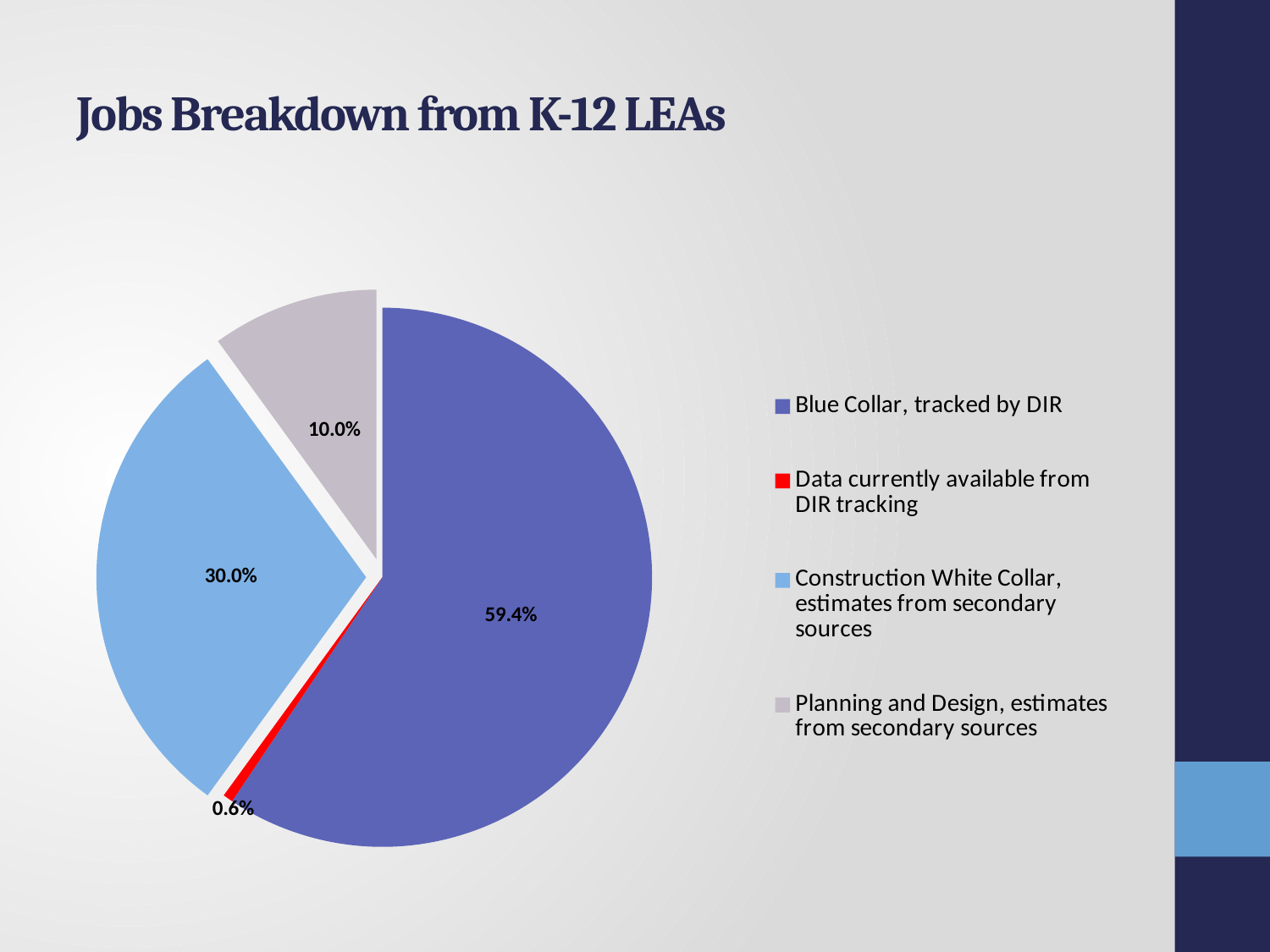
Which is larger: 'Planning and Design, estimates from secondary sources' or 'Construction White Collar, estimates from secondary sources'? Construction White Collar, estimates from secondary sources What is the title of the chart? Jobs Breakdown from K-12 LEAs What share of the pie is 'Blue Collar, tracked by DIR'? 59.4% What is the difference in percentage points between 'Blue Collar, tracked by DIR' and 'Construction White Collar, estimates from secondary sources'? 29.4 Which category has the largest slice of the pie? Blue Collar, tracked by DIR Which category has the smallest slice of the pie? Data currently available from DIR tracking What colour is the slice for 'Data currently available from DIR tracking'? Red What kind of chart is shown on the slide? Pie chart How many categories does the legend list? 4 What share of the pie is 'Construction White Collar, estimates from secondary sources'? 30.0% What share of the pie is 'Data currently available from DIR tracking'? 0.6%